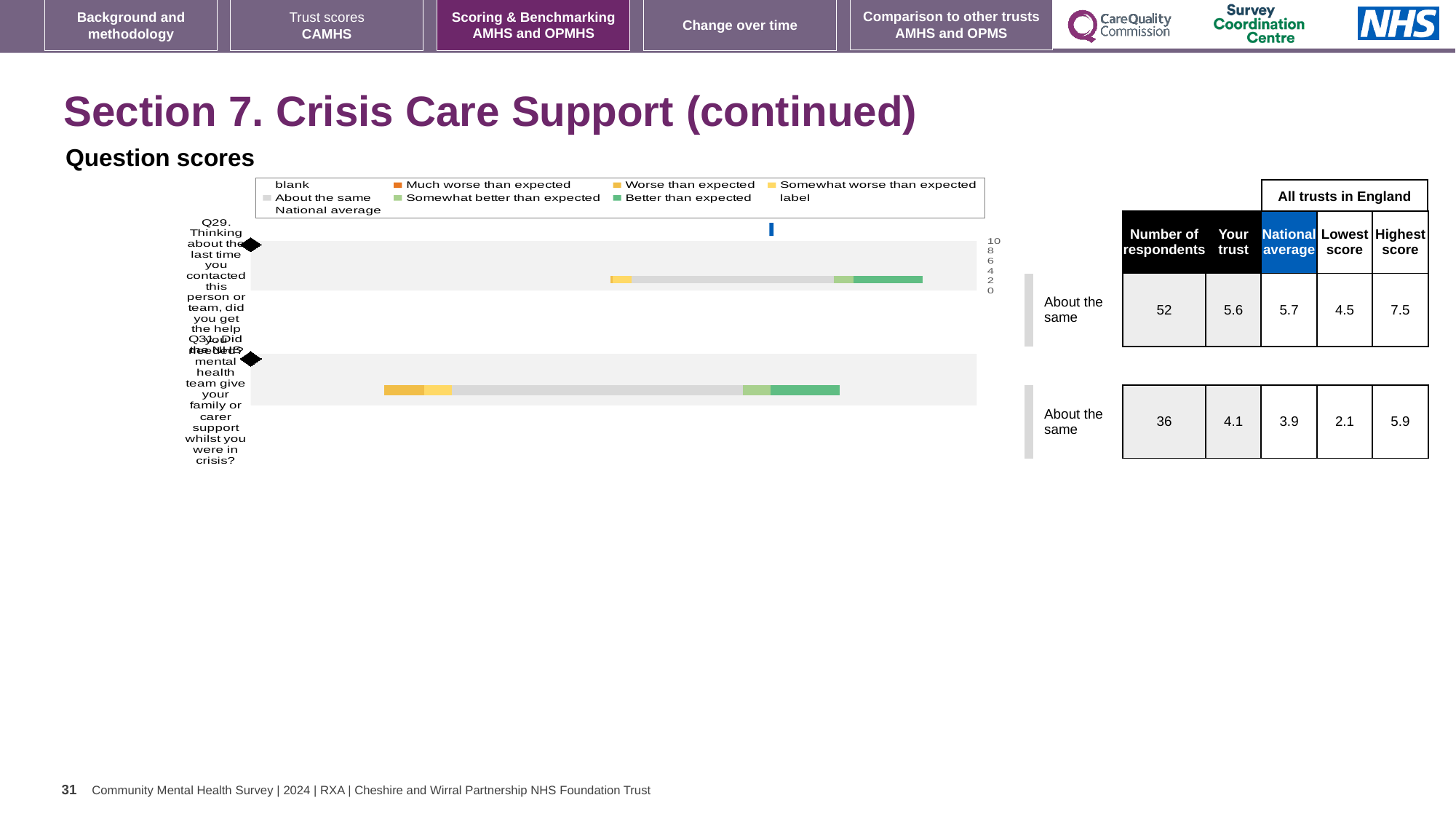
For Q31, what is the difference between the highest score and the lowest score? 3.8 In the table beside the chart, what is the lowest score for Q31? 2.1 What kind of chart is used to show the question scores on this slide? bar chart In the table beside the chart, what is the highest score for Q29? 7.5 In the table beside the chart, what is the 'Your trust' score for Q31? 4.1 For Q29, which is larger: the 'Your trust' score or the national average? National average What is the heading above the chart on this slide? Question scores What colour does the legend use for 'Better than expected'? green For Q31, which is larger: the 'Your trust' score or the national average? Your trust How many questions (bars) are plotted in the question scores chart? 2 How many entries does the legend of the question scores chart list? 9 In the table beside the chart, what is the number of respondents for Q29? 52